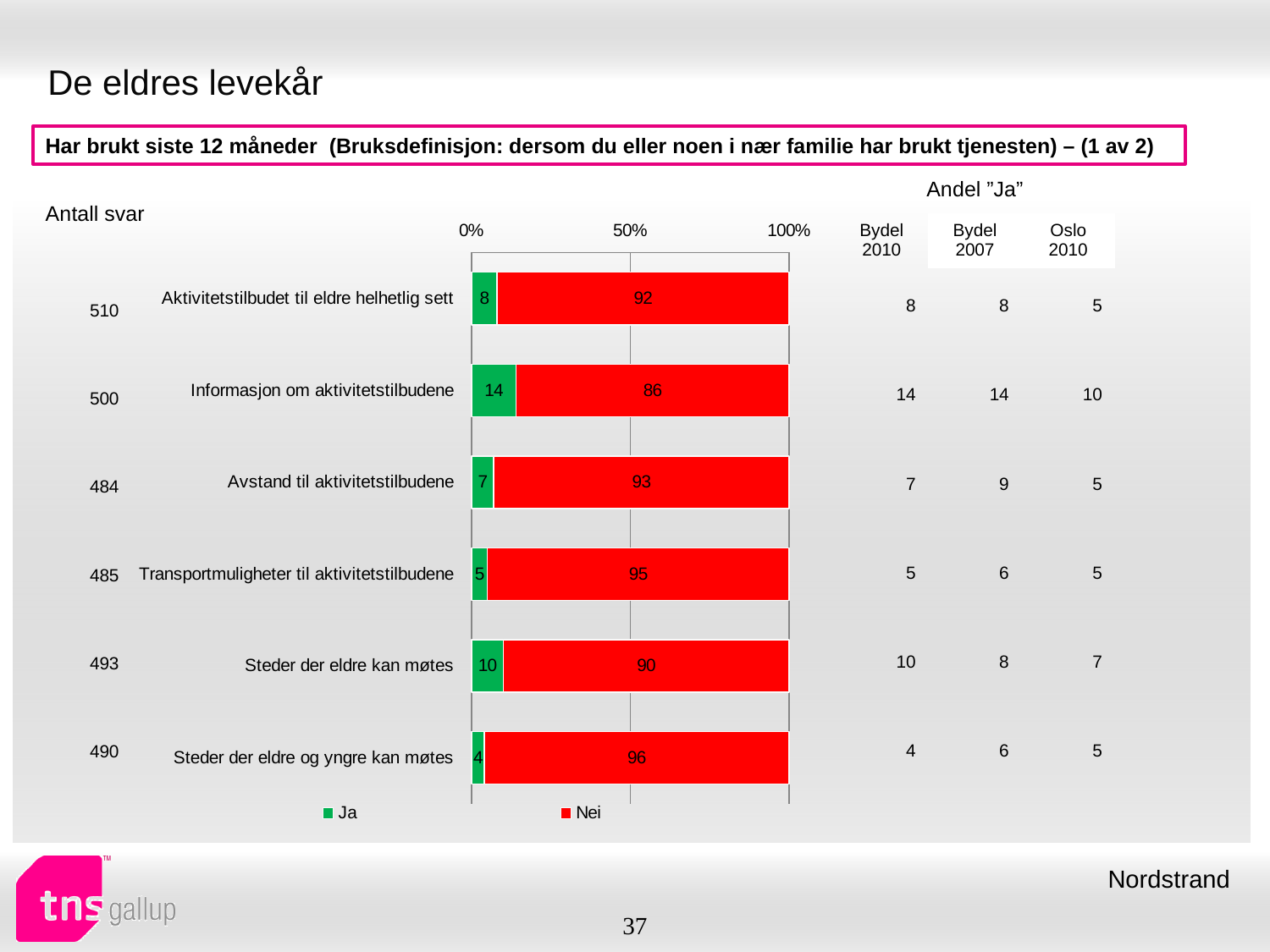
What is the "Nei" value for "Steder der eldre og yngre kan møtes"? 96 What kind of chart is shown on the slide? Stacked bar chart Is the "Nei" value for "Informasjon om aktivitetstilbudene" greater or less than 50%? greater Which category has the highest "Ja" value? Informasjon om aktivitetstilbudene Which category has the lowest "Ja" value? Steder der eldre og yngre kan møtes How many series does the legend list? 2 What is the "Nei" value for "Aktivitetstilbudet til eldre helhetlig sett"? 92 Which is larger: the "Ja" value for "Steder der eldre kan møtes" or for "Avstand til aktivitetstilbudene"? Steder der eldre kan møtes What colour represents the "Nei" series in the chart? Red How many categories are shown in the chart? 6 What is the difference between the "Nei" values for "Transportmuligheter til aktivitetstilbudene" and "Steder der eldre kan møtes"? 5 What is the "Ja" value for "Informasjon om aktivitetstilbudene"? 14